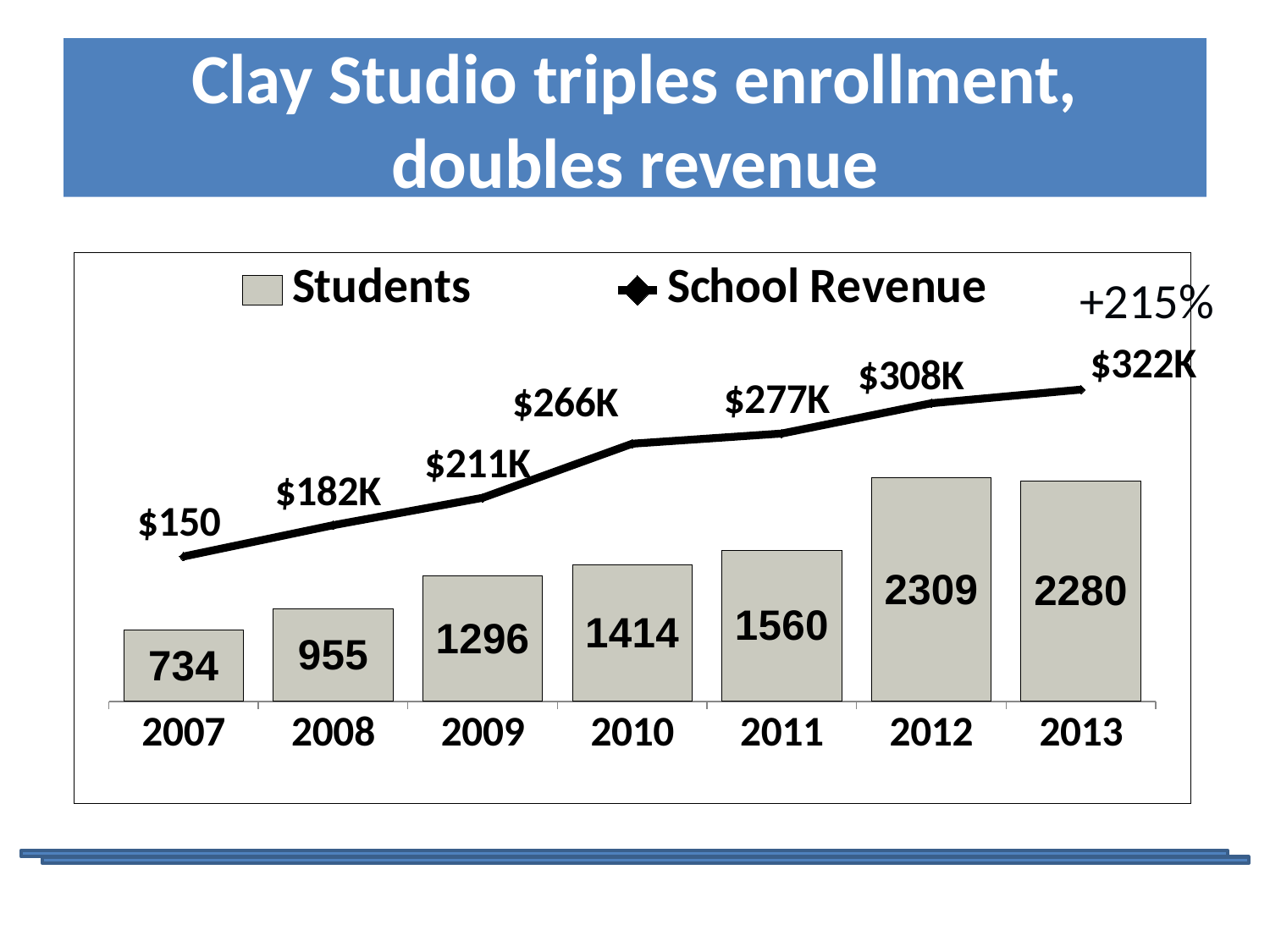
Does the School Revenue rise or fall from 2007 to 2013? rise What was the School Revenue in 2013? $322K Which year had the lowest School Revenue? 2007 How many years are shown on the x axis? 7 What are the two series named in the legend? Students and School Revenue How many students were enrolled in 2007? 734 What is the difference in students between 2012 and 2007? 1575 How many series does the legend list? 2 Which year had the highest number of students? 2012 Which year had more students, 2012 or 2013? 2012 What was the School Revenue in 2009? $211K How many students were enrolled in 2011? 1560